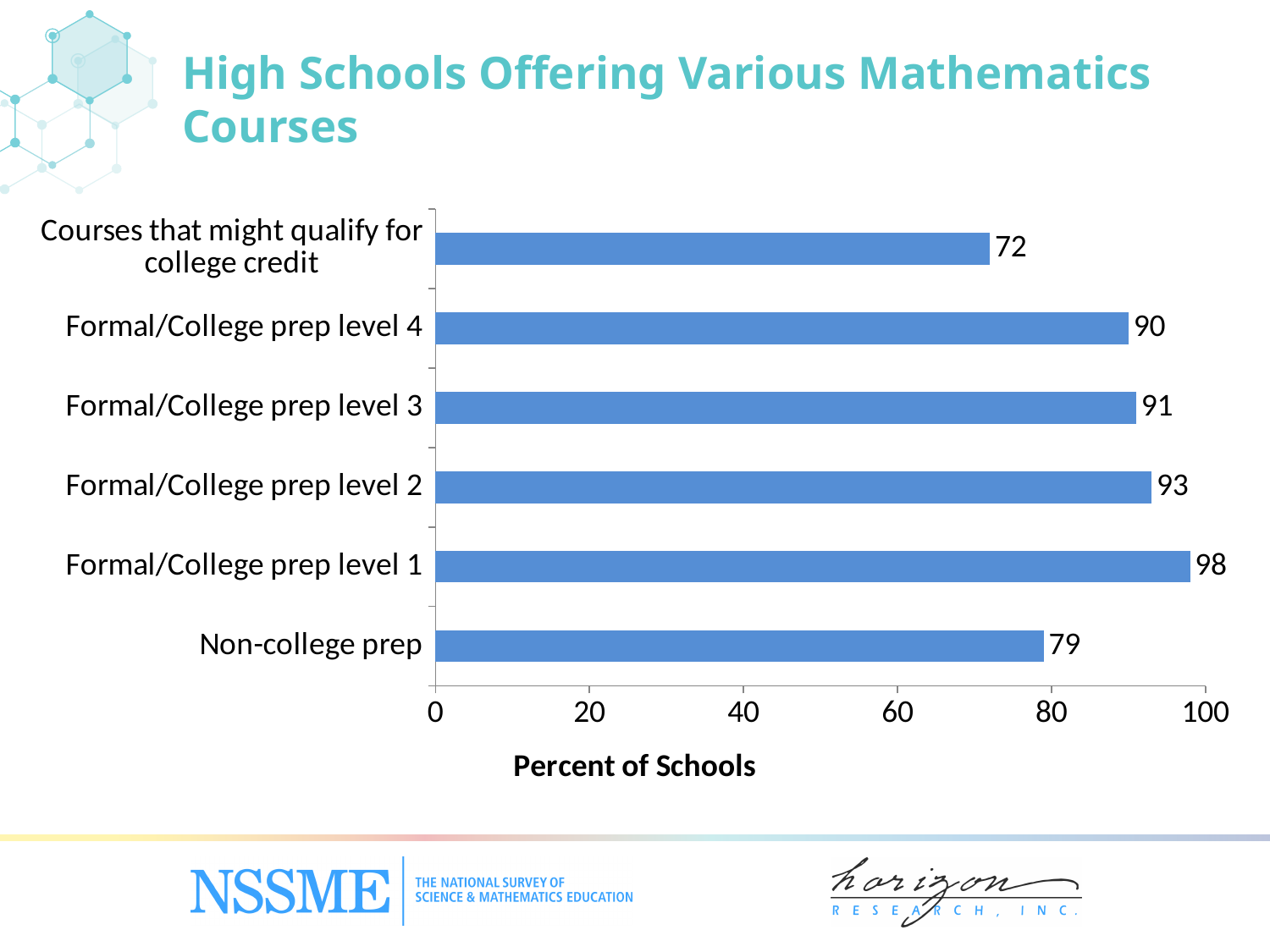
What is the value for Formal/College prep level 3? 91 What is the value for Formal/College prep level 1? 98 Which is larger, the value for Formal/College prep level 4 or the value for Non-college prep? Formal/College prep level 4 What percent of schools offer Non-college prep mathematics courses? 79 What is the difference between the values for Formal/College prep level 2 and Formal/College prep level 4? 3 Which category has the lowest percent of schools? Courses that might qualify for college credit What is the difference between the values for Formal/College prep level 1 and Non-college prep? 19 What kind of chart is shown on the slide? Bar chart Which category has the highest percent of schools? Formal/College prep level 1 What is the label of the horizontal axis? Percent of Schools How many categories are shown in the chart? 6 What is the value for Courses that might qualify for college credit? 72